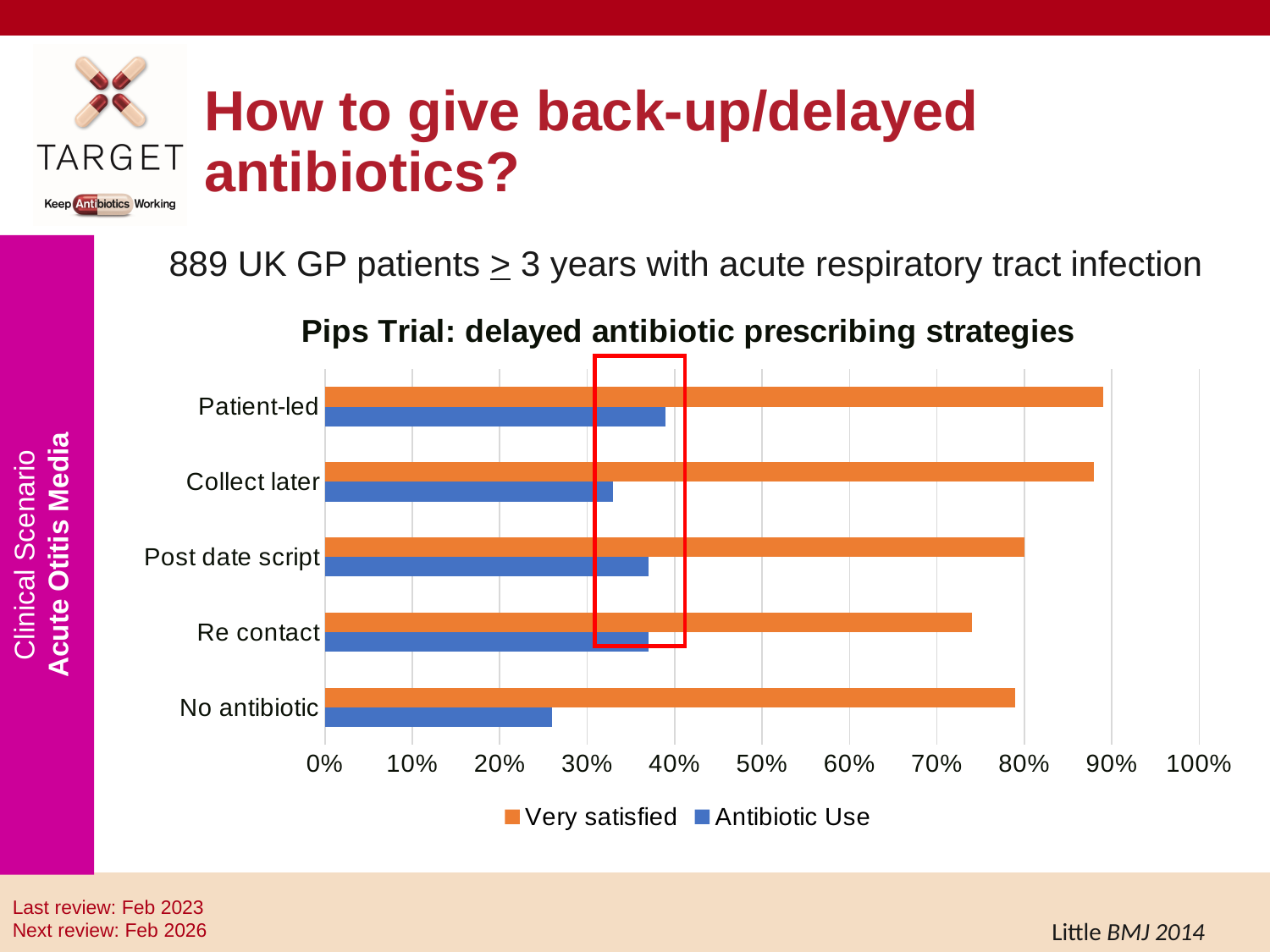
What kind of chart is shown on the slide? Bar chart Which colour represents the 'Antibiotic Use' series? Blue Is the 'Antibiotic Use' value for Collect later greater or less than 40%? less Which strategy has the lowest 'Antibiotic Use' value? No antibiotic Which has the larger 'Antibiotic Use' value: Collect later or Post date script? Post date script Is the 'Very satisfied' value for Patient-led greater or less than 80%? greater How many series does the chart legend list? 2 Is the 'Antibiotic Use' value for No antibiotic greater or less than 30%? less What is the title of the chart? Pips Trial: delayed antibiotic prescribing strategies How many prescribing strategies (categories) are shown on the chart? 5 Which strategy has the lowest 'Very satisfied' value? Re contact